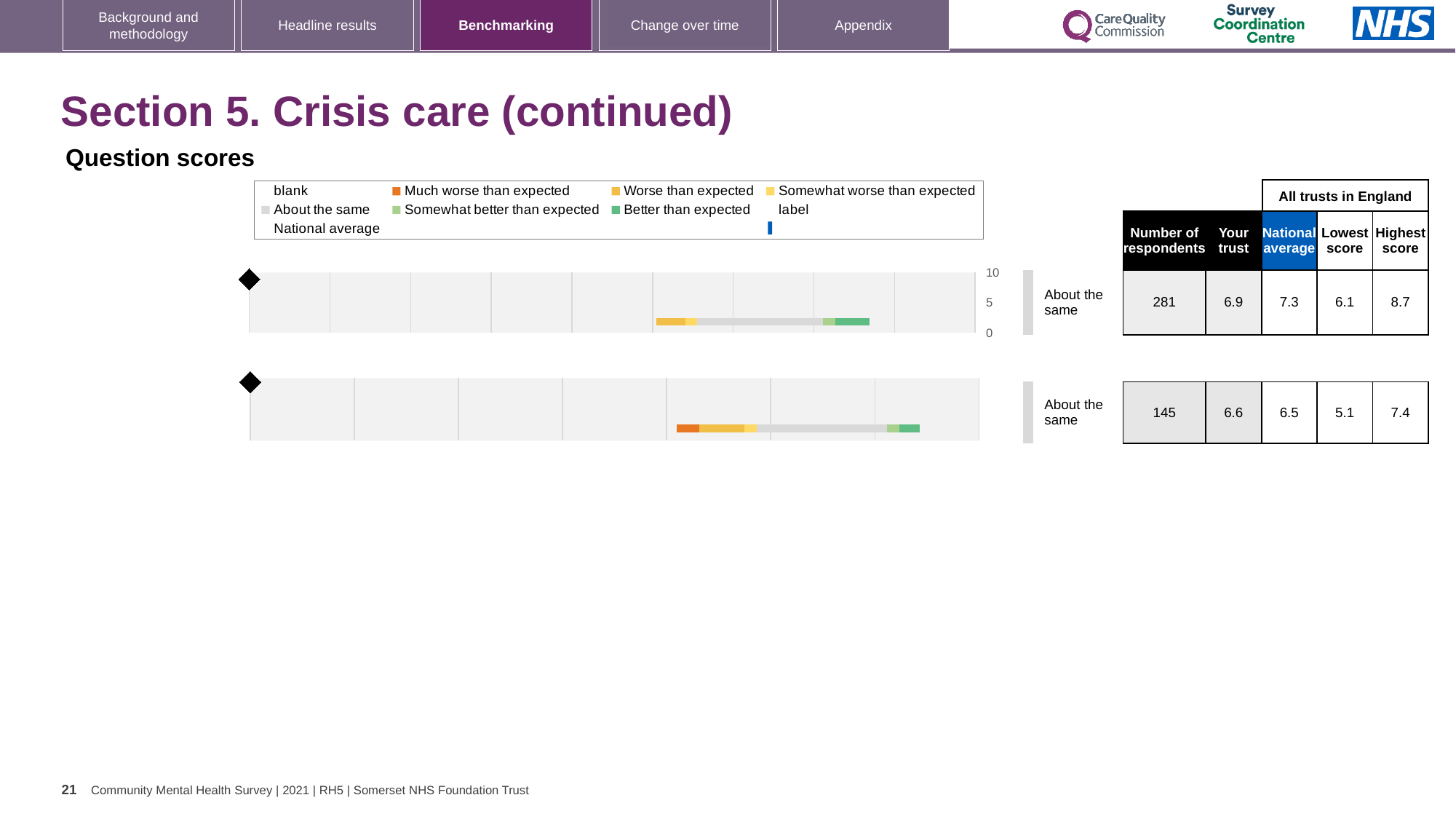
In the bottom chart, what is the Lowest score among all trusts in England? 5.1 What kind of chart is used to show the question scores on this slide? bar chart In the top chart, what is the Highest score among all trusts in England? 8.7 In the top chart, what is the score for Your trust? 6.9 In the top chart, what is the difference between the Highest score and the Lowest score? 2.6 In the top chart, what is the National average score? 7.3 In the bottom chart, what is the National average score? 6.5 In the bottom chart, what is the difference between the Your trust score and the National average? 0.1 In the top chart, is the Your trust score higher or lower than the National average? lower In the top chart, how many respondents are shown? 281 In the bottom chart, which benchmark category is the trust's score placed in? About the same In the bottom chart, what is the score for Your trust? 6.6